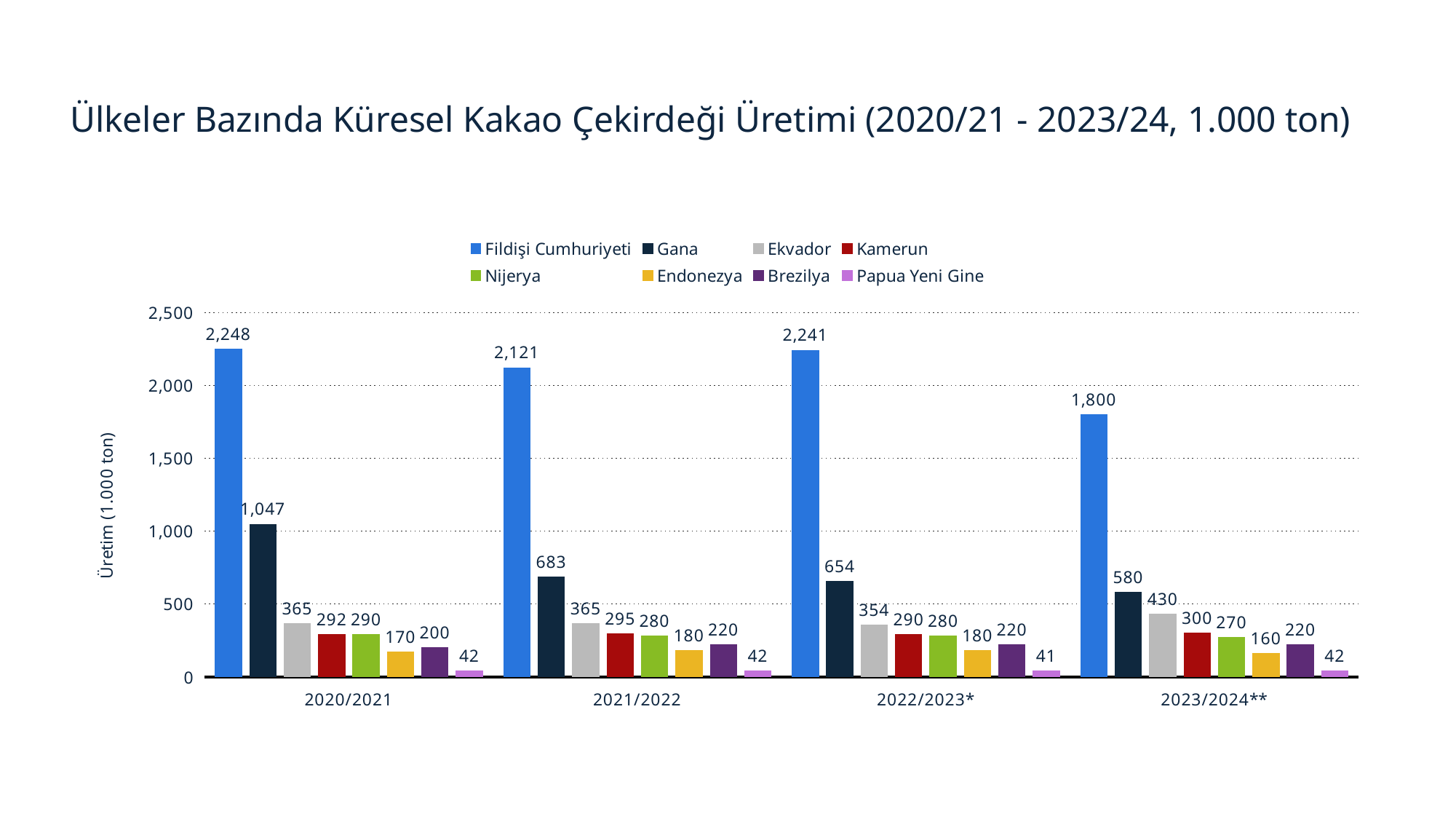
What is the difference between Fildişi Cumhuriyeti and Gana in 2023/2024**? 1,220 How many seasons are shown on the x axis? 4 Which is larger in 2021/2022: Kamerun or Nijerya? Kamerun How many series does the legend list? 8 What is the value for Gana in 2023/2024**? 580 Which country has the highest value in 2021/2022? Fildişi Cumhuriyeti What is the value for Fildişi Cumhuriyeti in 2020/2021? 2,248 What kind of chart is this? Bar chart Does the value for Gana rise or fall from 2020/2021 to 2023/2024**? Fall Which country has the lowest value in 2022/2023*? Papua Yeni Gine What is the value for Ekvador in 2022/2023*? 354 What is the value for Endonezya in 2020/2021? 170